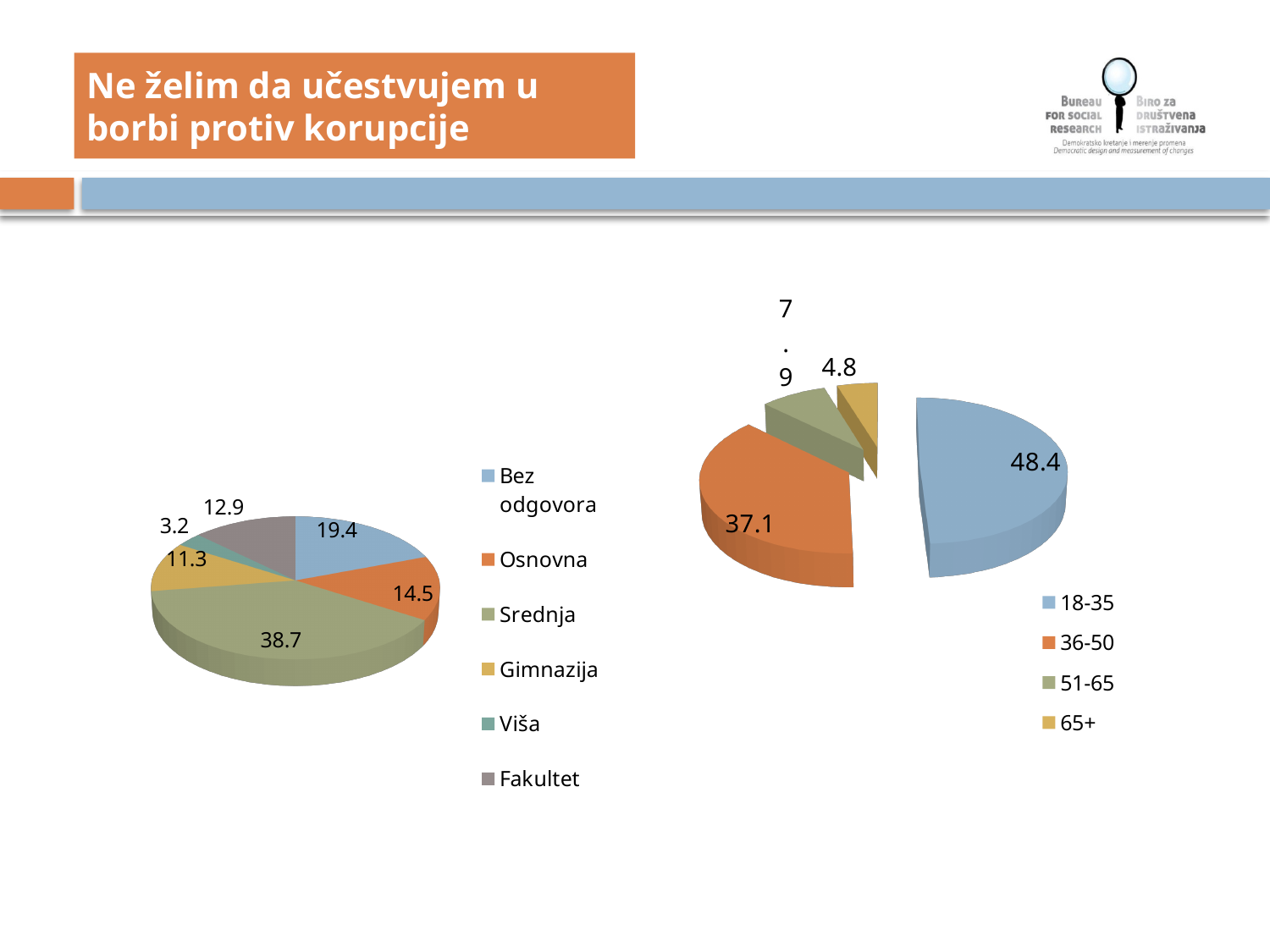
In the pie chart on the right, what is the difference between the values for 18-35 and 36-50? 11.3 In the pie chart on the right, what is the value for 36-50? 37.1 In the pie chart on the left, what is the value for Srednja? 38.7 In the pie chart on the left, which category has the largest slice? Srednja In the pie chart on the right, what is the value for 65+? 4.8 In the pie chart on the right, which is larger, the value for 51-65 or the value for 65+? 51-65 In the pie chart on the left, how many categories does the legend list? 6 In the pie chart on the right, which age group has the largest slice? 18-35 In the pie chart on the left, what is the value for Viša? 3.2 What kind of chart is shown on the right of the slide? Pie chart In the pie chart on the left, which category has the smallest slice? Viša In the pie chart on the left, what is the difference between the values for Bez odgovora and Osnovna? 4.9